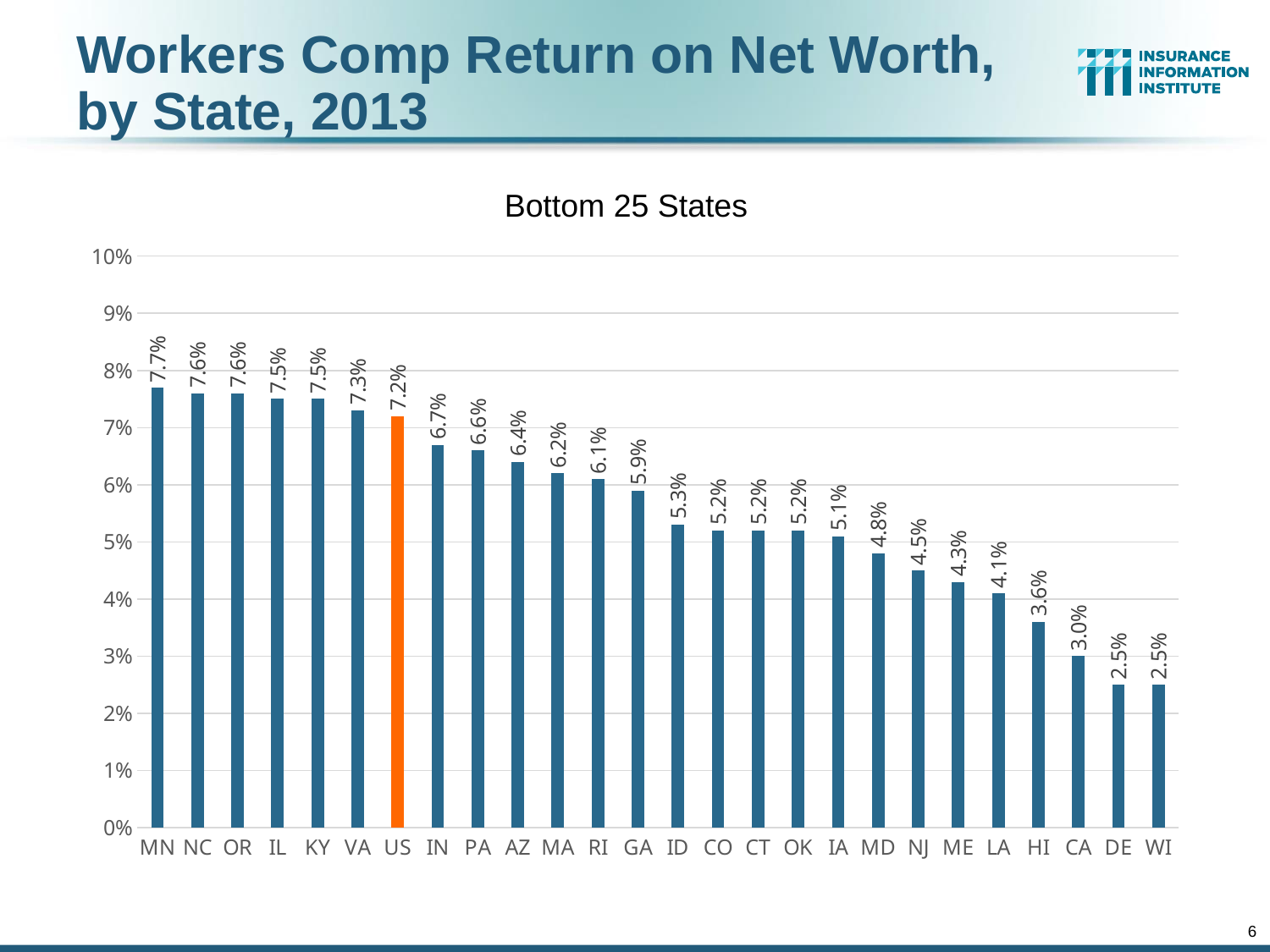
What kind of chart is shown on the slide? Bar chart What value is shown for the US bar? 7.2% Do the values rise or fall moving from left to right along the x axis? Fall What is the difference between the values for MN and CA? 4.7 percentage points What is the workers comp return on net worth for Indiana (IN)? 6.7% How many bars are plotted in the chart? 26 What is the value shown for Hawaii (HI)? 3.6% Which bar is coloured orange instead of blue? US Which has a higher return on net worth, GA or MD? GA What is the lowest value shown in the chart? 2.5% Which state has the highest return on net worth in the chart? MN Is the value for NJ greater or less than 5%? less